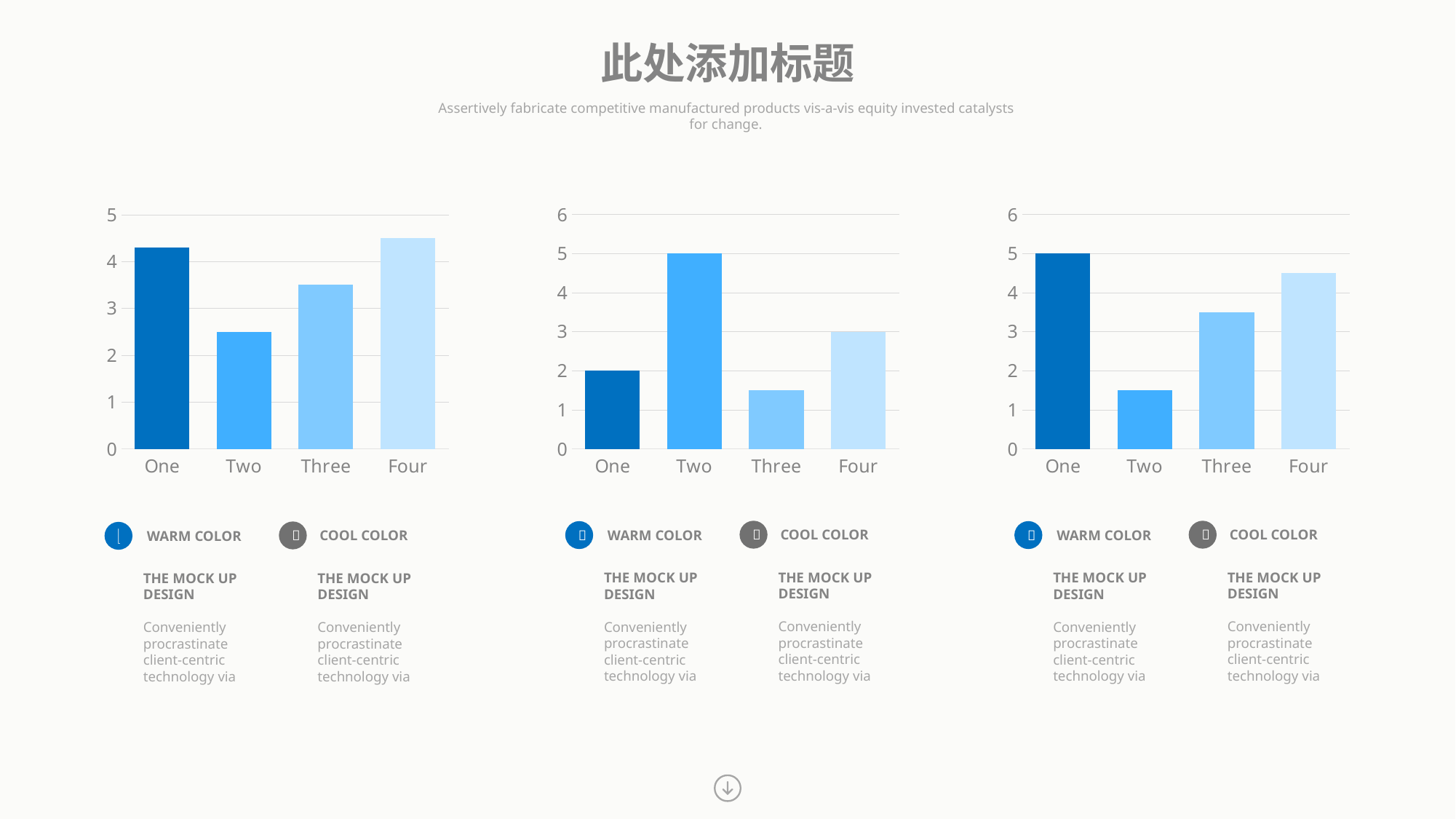
In the middle chart, what is the value for Four? 3 In the right chart, what is the value for One? 5 In the right chart, which category has the lowest value? Two In the middle chart, what is the value for One? 2 In the left chart, is the value for Three greater or less than 3? greater In the right chart, is the value for Four greater or less than 4? greater In the middle chart, which category has the lowest value? Three In the middle chart, what is the difference between the values for Two and One? 3 How many categories does the middle chart show on its x axis? 4 What kind of chart is the left chart on the slide? bar chart In the left chart, which category has the lowest value? Two In the middle chart, what is the value for Two? 5